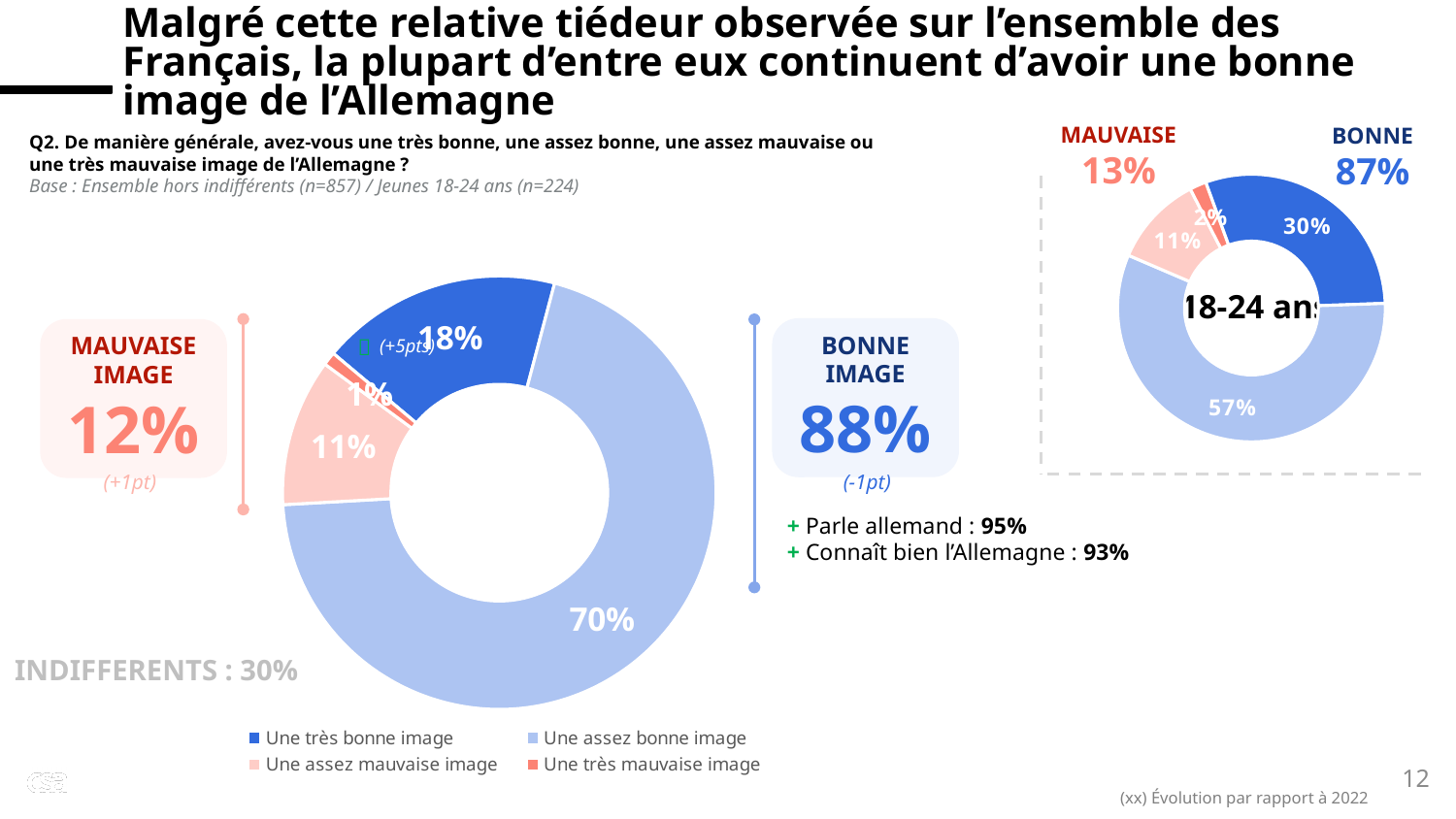
On the large doughnut chart, which category has the smallest slice? Une très mauvaise image On the large doughnut chart, what is the difference between the 'Une assez bonne image' and 'Une très bonne image' slices? 52 points On the large doughnut chart, which category has the largest slice? Une assez bonne image On the small '18-24 ans' doughnut chart, what share is labelled for 'Une assez bonne image'? 57% On the large doughnut chart, what share is labelled for 'Une très mauvaise image'? 1% On the large doughnut chart, what share is labelled for 'Une assez mauvaise image'? 11% On the small '18-24 ans' doughnut chart, what share is labelled for 'Une très bonne image'? 30% What kind of chart is the large chart on the slide? Doughnut (pie) chart On the large doughnut chart, what share is labelled for 'Une très bonne image'? 18% How many entries does the legend of the large chart list? 4 On the small '18-24 ans' doughnut chart, which is larger: the 'Une très bonne image' slice or the 'Une assez mauvaise image' slice? Une très bonne image On the large doughnut chart, what share is labelled for 'Une assez bonne image'? 70%